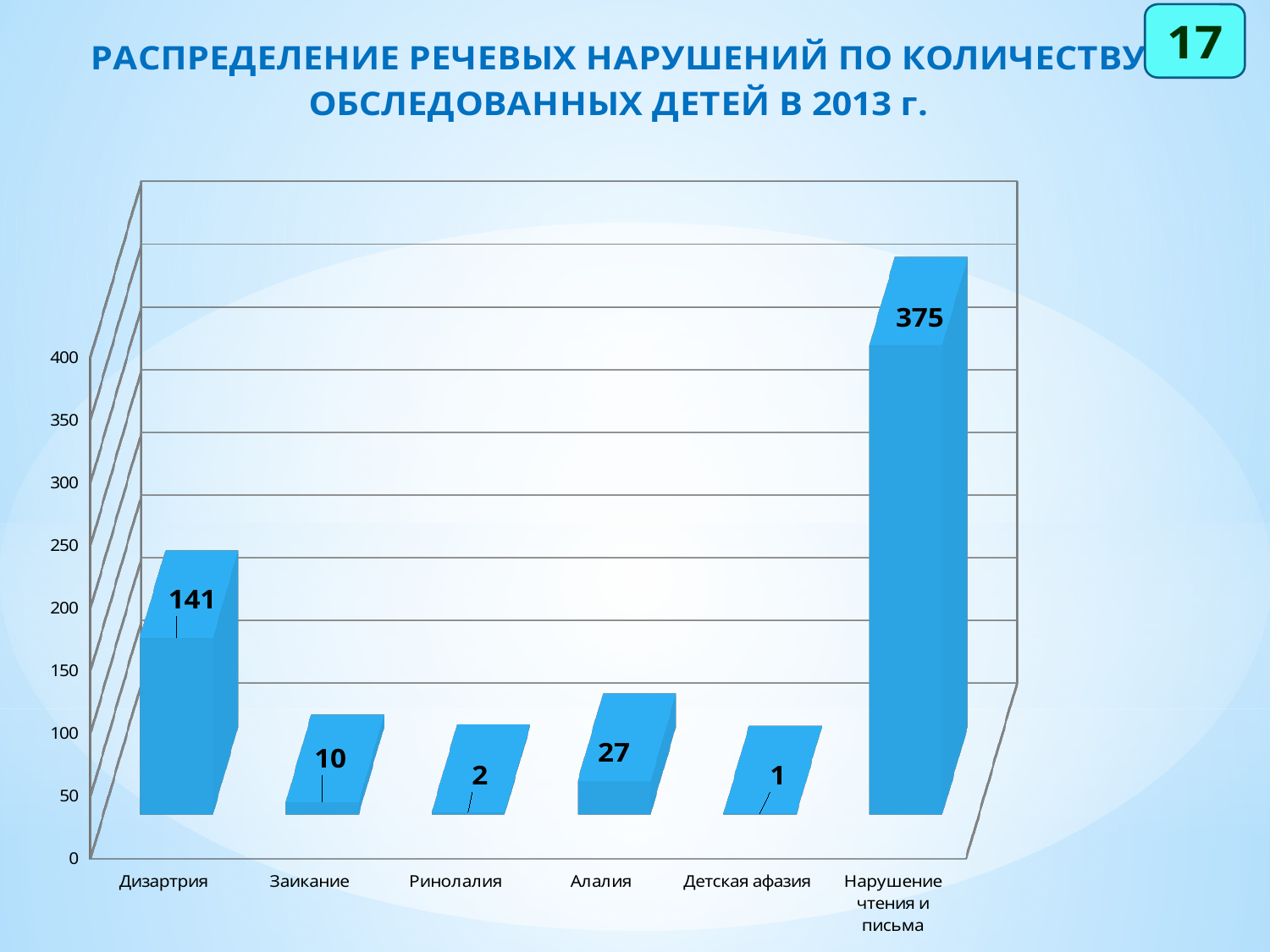
Which category has the highest value? Нарушение чтения и письма What is the difference between the values for Заикание and Ринолалия? 8 Which is larger, the value for Заикание or the value for Алалия? Алалия How many categories are shown on the x axis? 6 What is the value for Дизартрия? 141 What is the value for Нарушение чтения и письма? 375 What year is mentioned in the chart title? 2013 What is the value for Детская афазия? 1 What is the value for Алалия? 27 Which category has the lowest value? Детская афазия What is the difference between the values for Нарушение чтения и письма and Дизартрия? 234 What kind of chart is shown on the slide? Bar chart